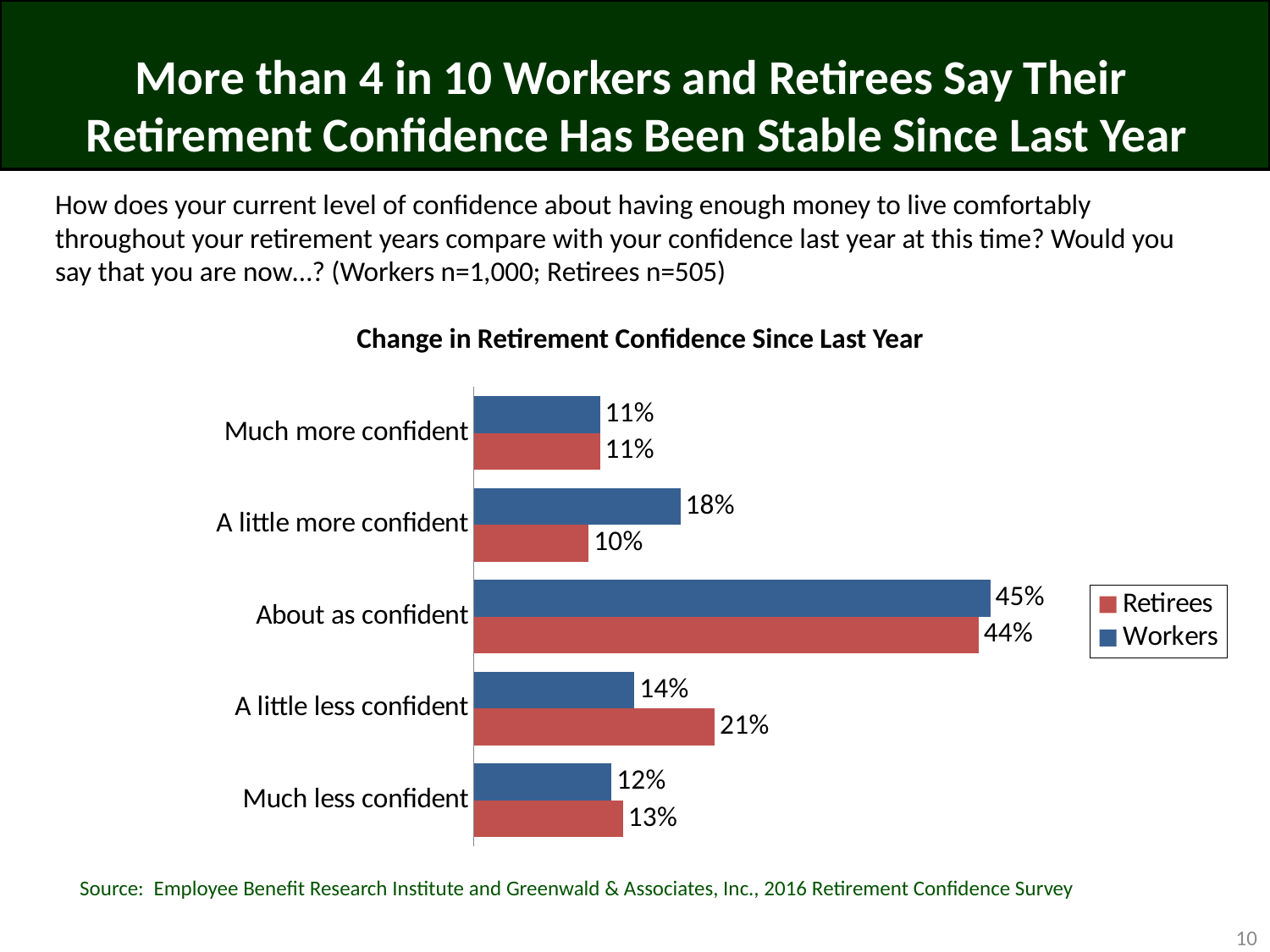
For 'A little less confident', which group has the larger value, Workers or Retirees? Retirees What percentage of Retirees say they are 'A little more confident'? 10% How many series does the legend list? 2 How many categories are shown on the chart? 5 What kind of chart is shown on the slide? Bar chart Which category has the lowest value for Workers? Much more confident What is the difference between Retirees and Workers for 'A little less confident'? 7 percentage points What percentage of Workers say they are 'About as confident'? 45% Which category has the highest value for Retirees? About as confident What percentage of Retirees say they are 'A little less confident'? 21% What is the difference between Workers and Retirees for 'A little more confident'? 8 percentage points What is the title of the chart? Change in Retirement Confidence Since Last Year